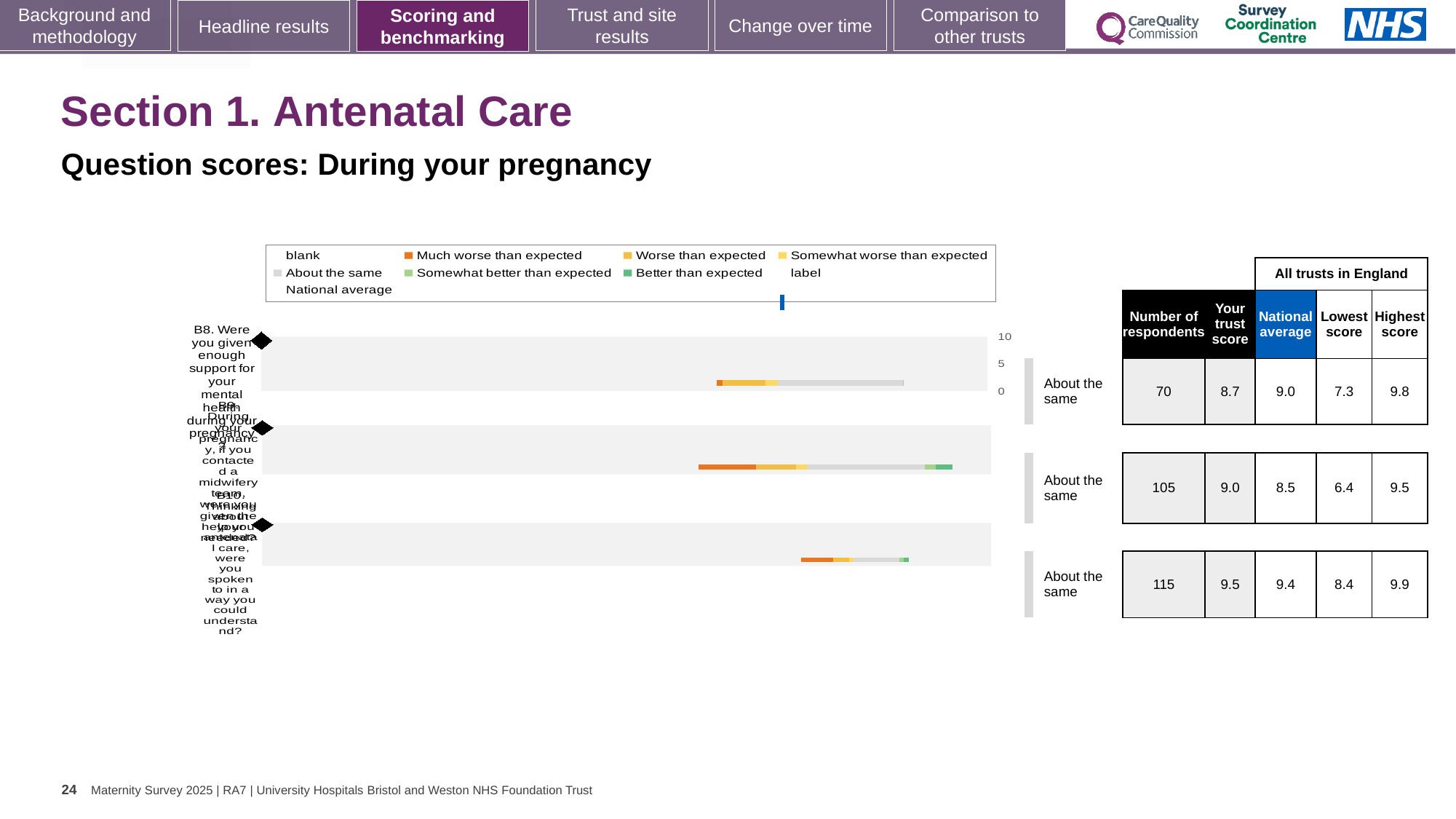
Which question row has the highest trust score? The third row (9.5) What is the number of respondents for the first question row (B8, support for mental health during pregnancy)? 70 What is the national average for the second question row? 8.5 For the first question row (B8), which is larger: the trust score or the national average? National average (9.0) What is the trust score for the first question row (B8)? 8.7 What is the highest score among all trusts in England for the third question row? 9.9 How many survey questions (rows) are plotted in the chart? 3 What is the lowest score among all trusts in England for the second question row? 6.4 What is the difference between the highest score and the lowest score for the first question row (B8)? 2.5 What benchmark category is shown for all three question rows? About the same What kind of chart is used to show the question scores on this slide? Bar chart What is the highest value shown on the chart's score axis? 10